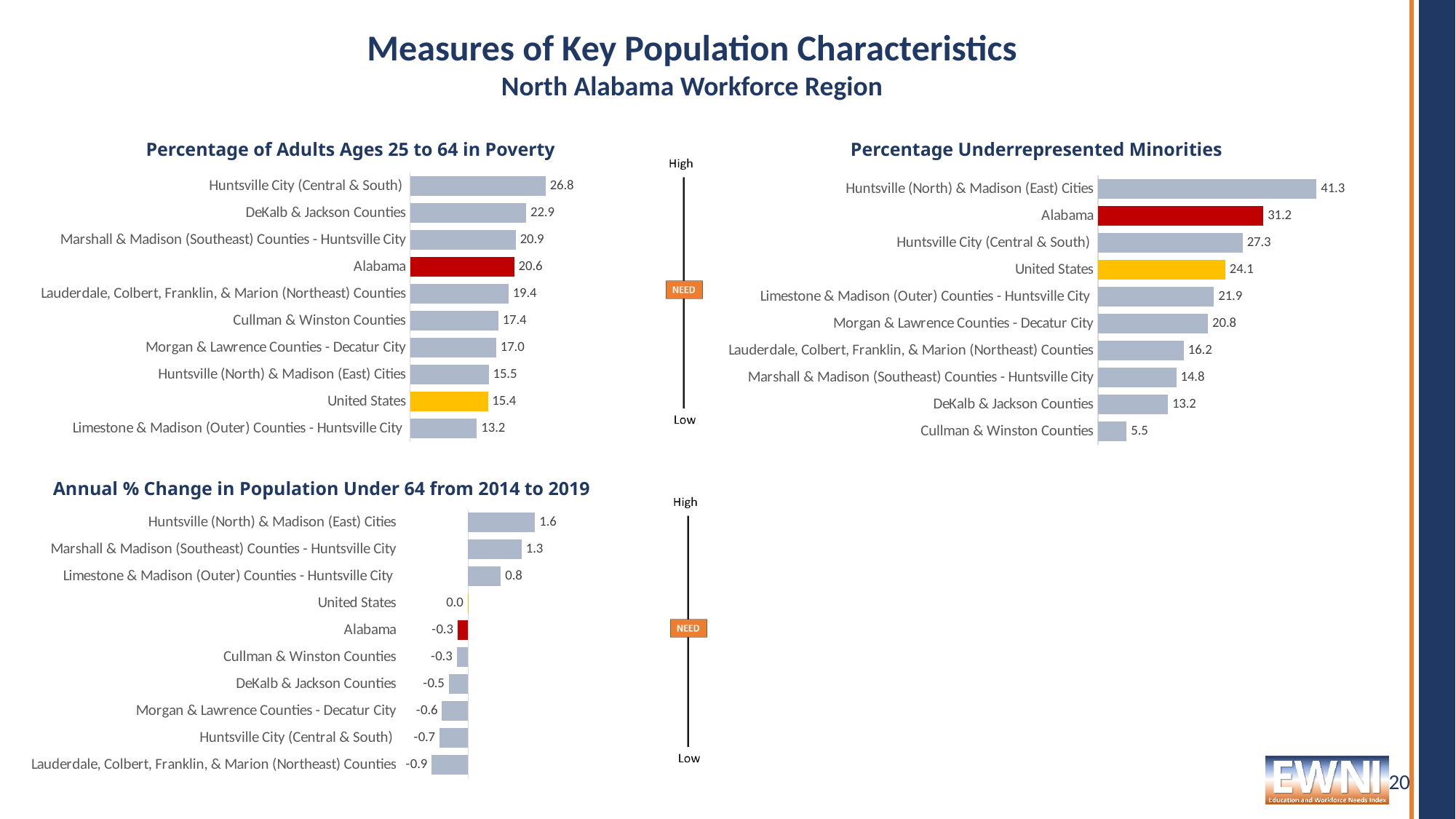
In the 'Percentage Underrepresented Minorities' chart, which category has the lowest value? Cullman & Winston Counties In the 'Percentage of Adults Ages 25 to 64 in Poverty' chart, which category has the highest value? Huntsville City (Central & South) In the 'Percentage of Adults Ages 25 to 64 in Poverty' chart, what is the difference between Huntsville City (Central & South) and the United States? 11.4 In the 'Percentage Underrepresented Minorities' chart, which is larger: Alabama or Huntsville City (Central & South)? Alabama In the 'Percentage of Adults Ages 25 to 64 in Poverty' chart, what is the value for Alabama? 20.6 In the 'Annual % Change in Population Under 64 from 2014 to 2019' chart, which category has the lowest value? Lauderdale, Colbert, Franklin, & Marion (Northeast) Counties In the 'Annual % Change in Population Under 64 from 2014 to 2019' chart, what is the difference between Marshall & Madison (Southeast) Counties - Huntsville City and Limestone & Madison (Outer) Counties - Huntsville City? 0.5 In the 'Percentage Underrepresented Minorities' chart, what is the value for the United States? 24.1 In the 'Annual % Change in Population Under 64 from 2014 to 2019' chart, what is the value for Huntsville (North) & Madison (East) Cities? 1.6 What kind of chart is the 'Percentage of Adults Ages 25 to 64 in Poverty' chart? Bar chart In the 'Percentage Underrepresented Minorities' chart, how many categories are shown? 10 In the 'Percentage of Adults Ages 25 to 64 in Poverty' chart, which category has the lowest value? Limestone & Madison (Outer) Counties - Huntsville City